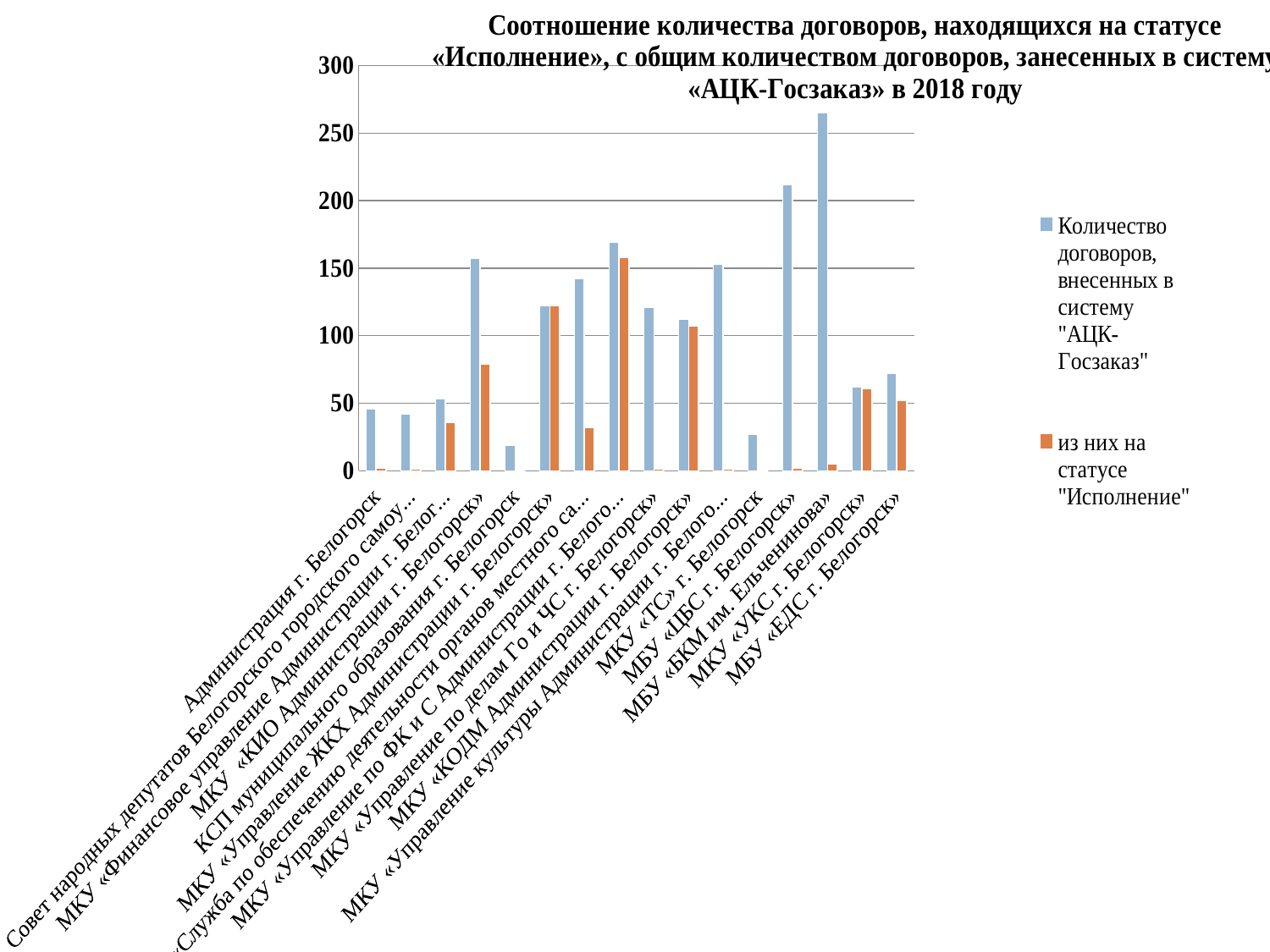
How many series does the legend list? 2 Which series contains the tallest bar on the chart, "Количество договоров, внесенных в систему "АЦК-Госзаказ"" or "из них на статусе "Исполнение""? Количество договоров, внесенных в систему "АЦК-Госзаказ" What is the first series named in the legend? Количество договоров, внесенных в систему "АЦК-Госзаказ" Is the tallest bar of the series "из них на статусе "Исполнение"" greater or less than 200? less What is the second series named in the legend? из них на статусе "Исполнение" Is the tallest bar of the series "Количество договоров, внесенных в систему "АЦК-Госзаказ"" greater or less than 250? greater What is the highest value shown on the vertical axis? 300 What kind of chart is shown on the slide? bar chart Is the tallest bar of the series "из них на статусе "Исполнение"" greater or less than 150? greater